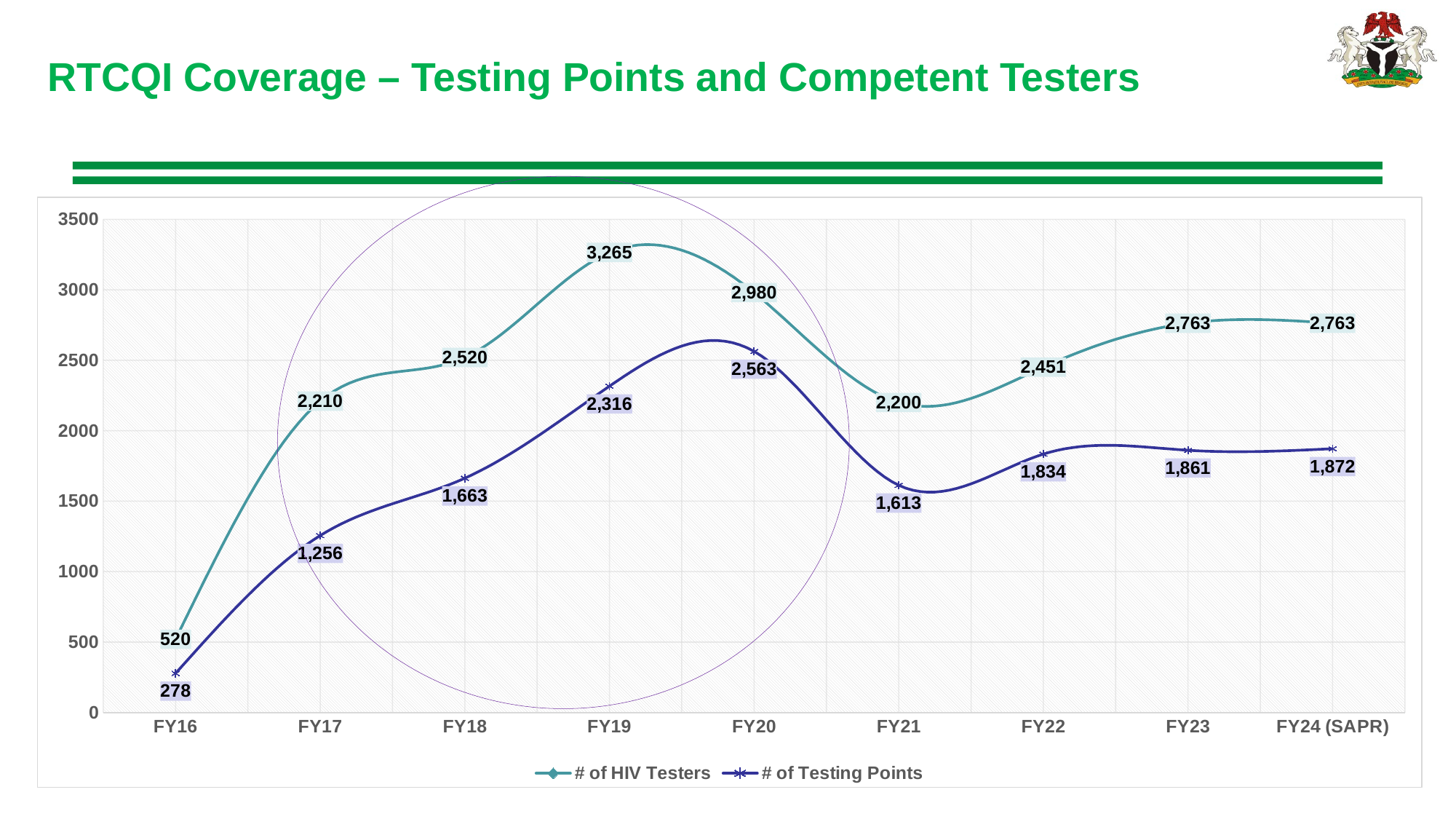
How many fiscal years are shown on the x axis? 9 What is the number of HIV Testers in FY19? 3,265 What kind of chart is shown on the slide? Line chart What is the number of Testing Points in FY21? 1,613 In which fiscal year is the number of HIV Testers highest? FY19 How many series does the legend list? 2 Which is larger in FY18: the number of HIV Testers or the number of Testing Points? # of HIV Testers In which fiscal year is the number of Testing Points lowest? FY16 What is the title of the slide? RTCQI Coverage – Testing Points and Competent Testers What is the difference between the number of HIV Testers and the number of Testing Points in FY20? 417 What is the number of Testing Points in FY24 (SAPR)? 1,872 Does the number of Testing Points rise or fall from FY16 to FY20? Rise